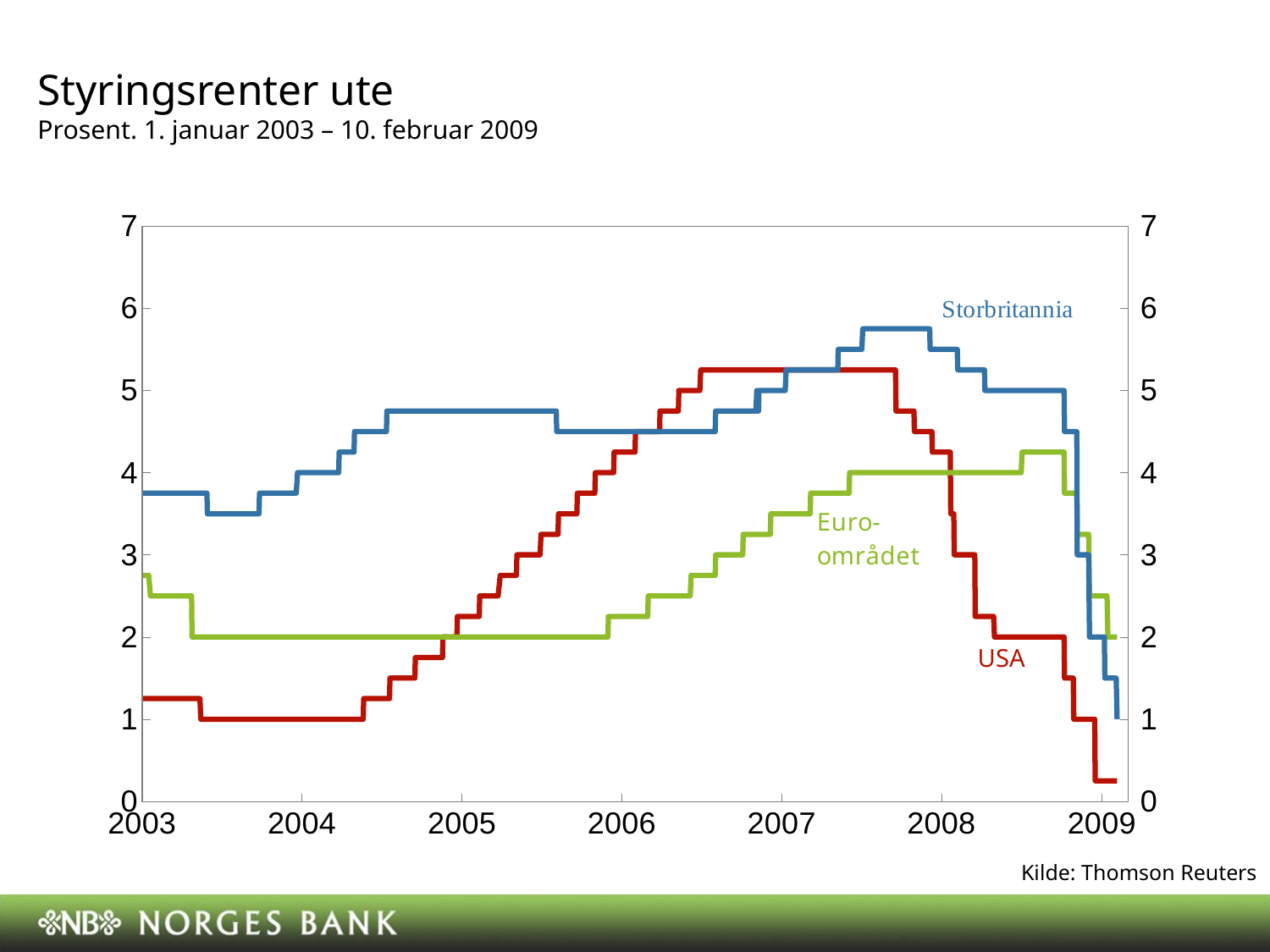
Is the value for Storbritannia in late 2007 greater or less than 5? greater Which series has the highest value at the start of 2003? Storbritannia Which series reaches the highest peak on the chart? Storbritannia What is the value for USA during the first half of 2004? 1 Does the USA series rise or fall from 2004 to 2006? rise Which series has the lowest value at the end of the period in 2009? USA What kind of chart is shown on the slide? line chart What is the title of the chart? Styringsrenter ute How many series are plotted on the chart? 3 In 2005, which is larger: the value for Storbritannia or the value for Euroområdet? Storbritannia What is the value for Euroområdet during 2004? 2